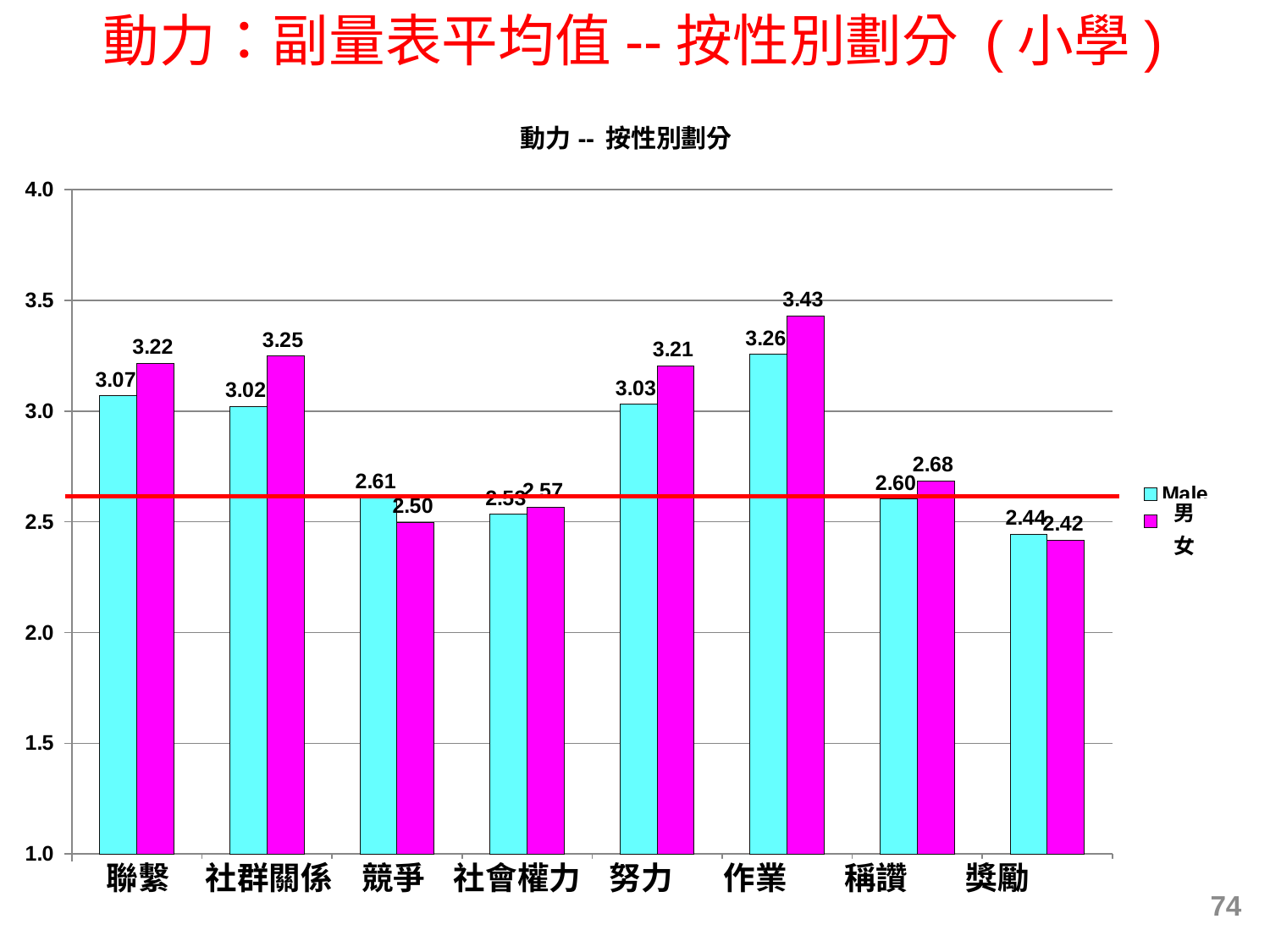
Which category has the highest value for 女? 作業 Which category has the lowest value for 男? 獎勵 What is the difference between the 女 and 男 values in the 作業 category? 0.17 What is the value for 女 in the 社群關係 category? 3.25 How many series does the legend list? 2 What is the value for 男 in the 作業 category? 3.26 Is the value for 女 in the 努力 category greater or less than 3.0? greater What is the value for 男 in the 獎勵 category? 2.44 How many categories are shown on the x axis? 8 What is the value for 女 in the 稱讚 category? 2.68 In the 競爭 category, which is larger, the 男 value or the 女 value? 男 What kind of chart is shown on the slide? Bar chart